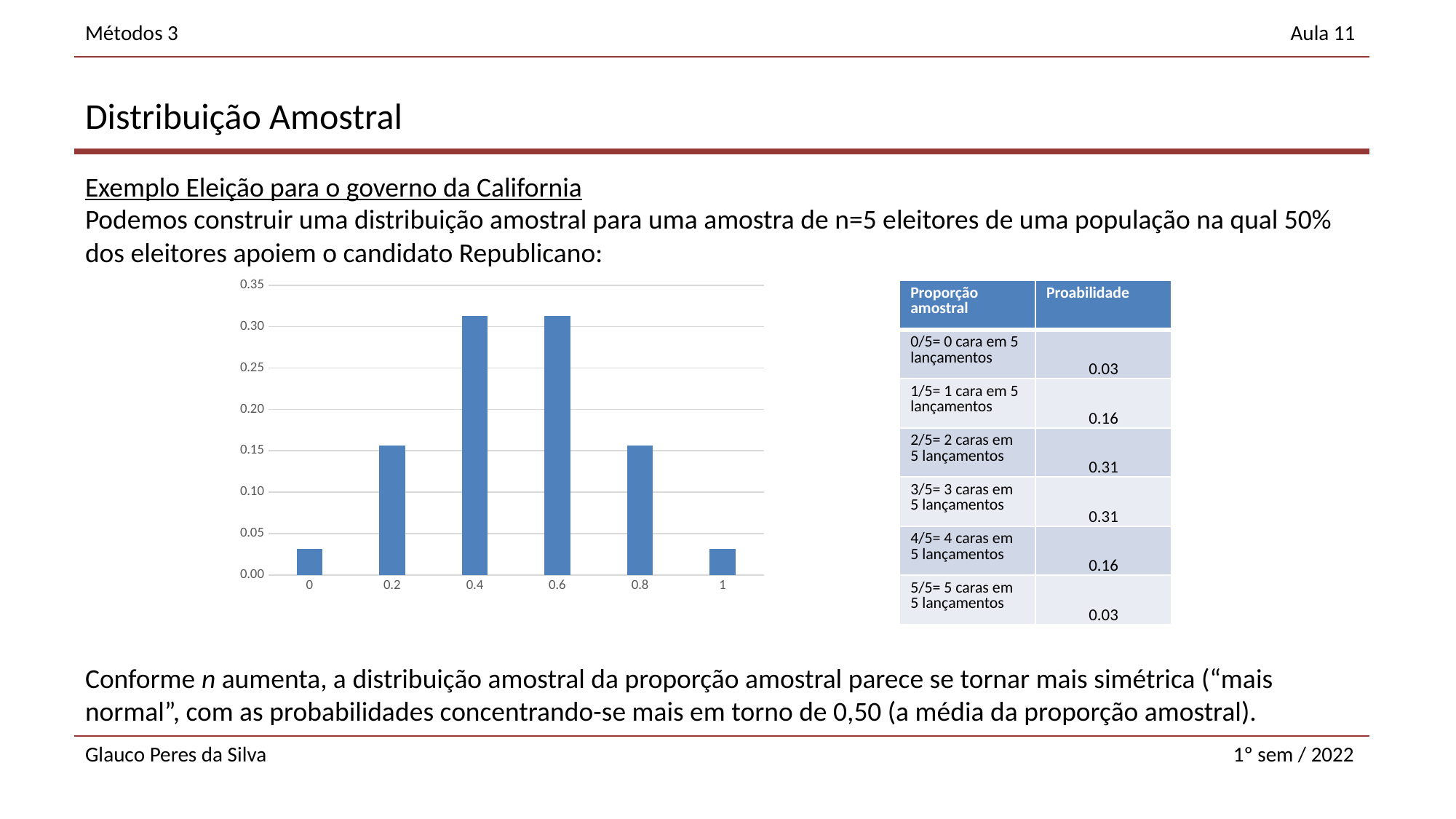
Which two categories on the x axis have the shortest bars? 0 and 1 Which bar is taller, the one for 0.2 or the one for 0.4? 0.4 Which two categories on the x axis have the tallest bars? 0.4 and 0.6 Is the bar for 0.4 greater or less than 0.25? greater How many bars (categories) does the chart show? 6 Is the bar for 0 greater or less than 0.05? less What is the highest value shown on the chart's y axis? 0.35 What kind of chart is shown on the slide? bar chart Do the bar heights rise, fall, or rise and then fall as you move from 0 to 1 along the x axis? rise and then fall Is the bar for 0.2 greater or less than 0.20? less Which bar is taller, the one for 1 or the one for 0.8? 0.8